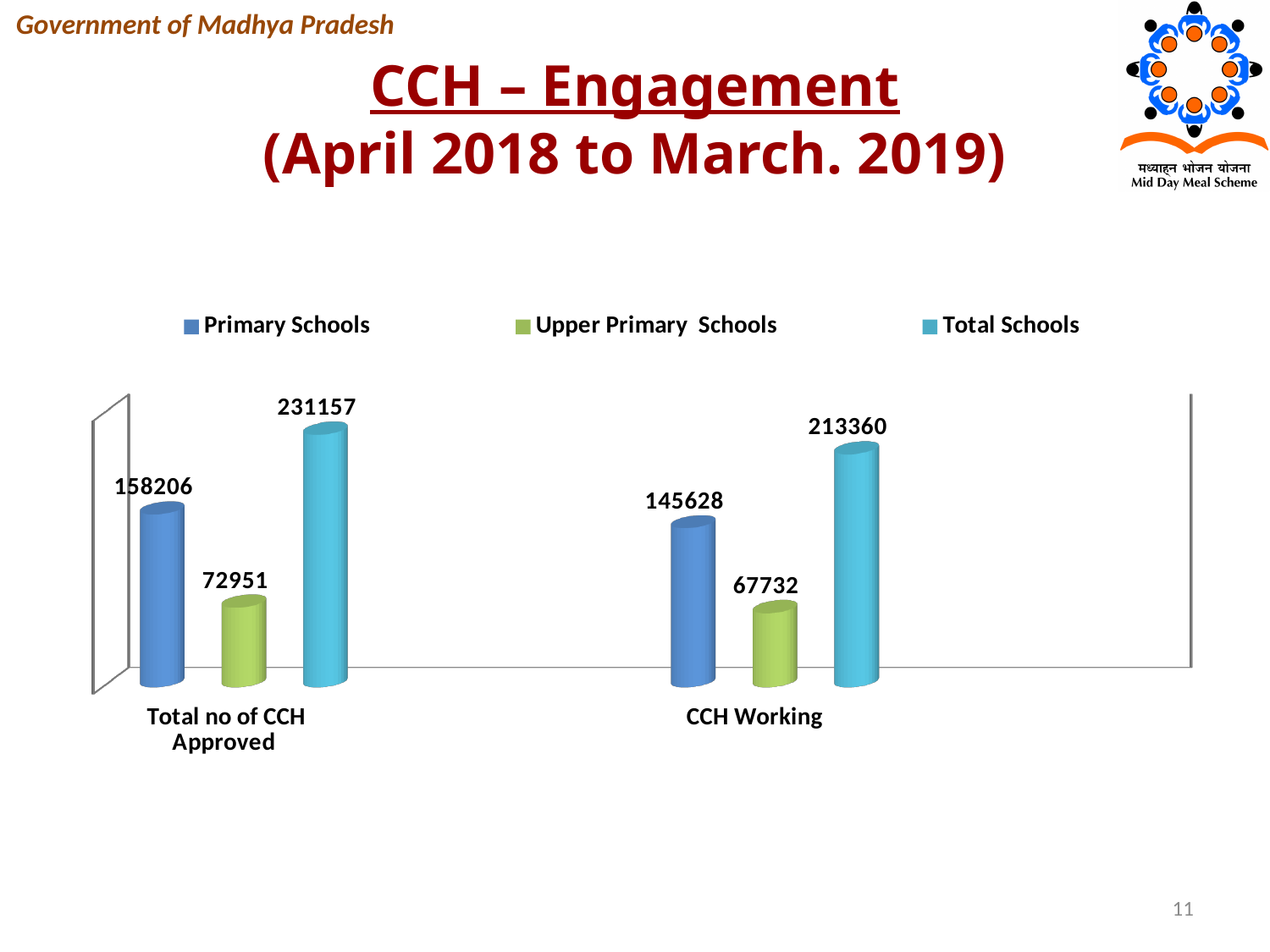
What is the value for Total Schools in the Total no of CCH Approved category? 231157 How many categories are shown on the x axis? 2 What is the difference between Primary Schools and Upper Primary Schools in the Total no of CCH Approved category? 85255 How many series does the legend list? 3 What is the value for Primary Schools in the Total no of CCH Approved category? 158206 Which is larger: Primary Schools for Total no of CCH Approved or Primary Schools for CCH Working? Total no of CCH Approved What kind of chart is shown on the slide? Bar chart What is the difference between Total Schools for Total no of CCH Approved and Total Schools for CCH Working? 17797 What is the value for Upper Primary Schools in the CCH Working category? 67732 What is the value for Total Schools in the CCH Working category? 213360 Which series has the highest value in the Total no of CCH Approved category? Total Schools Which series has the lowest value in the CCH Working category? Upper Primary Schools